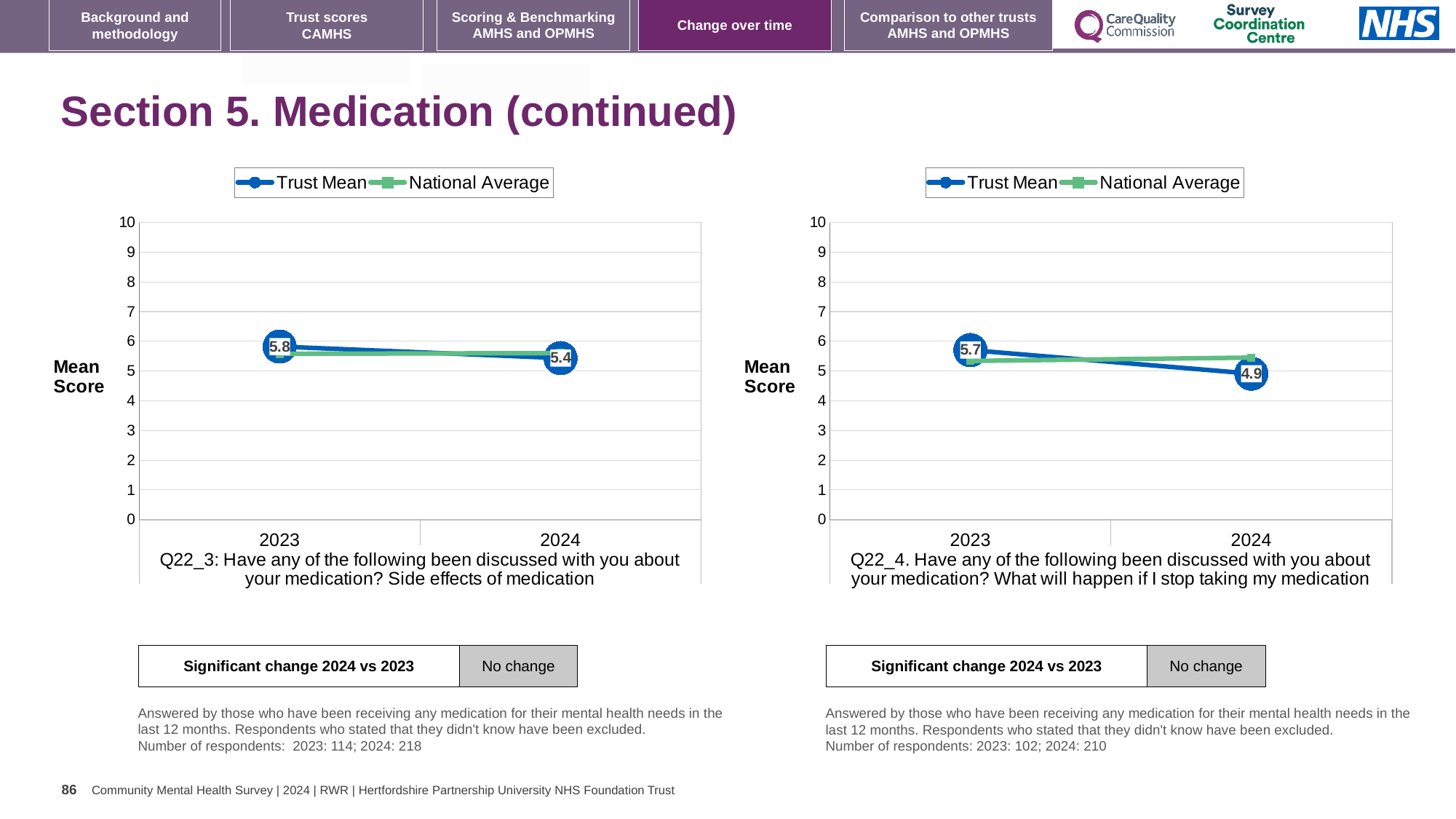
In the Q22_4 chart (right), what is the difference between the Trust Mean in 2023 and in 2024? 0.8 In the Q22_3 chart (left), what is the Trust Mean for 2024? 5.4 In the Q22_4 chart (right), what is the Trust Mean for 2023? 5.7 In the Q22_3 chart (left), by how much did the Trust Mean change from 2023 to 2024? 0.4 In the Q22_4 chart (right), what is the Trust Mean for 2024? 4.9 What kind of chart is the Q22_3 chart on the left? line chart In the Q22_4 chart (right), is the Trust Mean for 2024 greater or less than 5? less In the Q22_4 chart (right), which is larger in 2024, the Trust Mean or the National Average? National Average How many series does the legend of the Q22_4 chart (right) list? 2 How many years are shown on the x axis of the Q22_3 chart (left)? 2 In the Q22_4 chart (right), does the Trust Mean rise or fall from 2023 to 2024? fall In the Q22_3 chart (left), what is the Trust Mean for 2023? 5.8